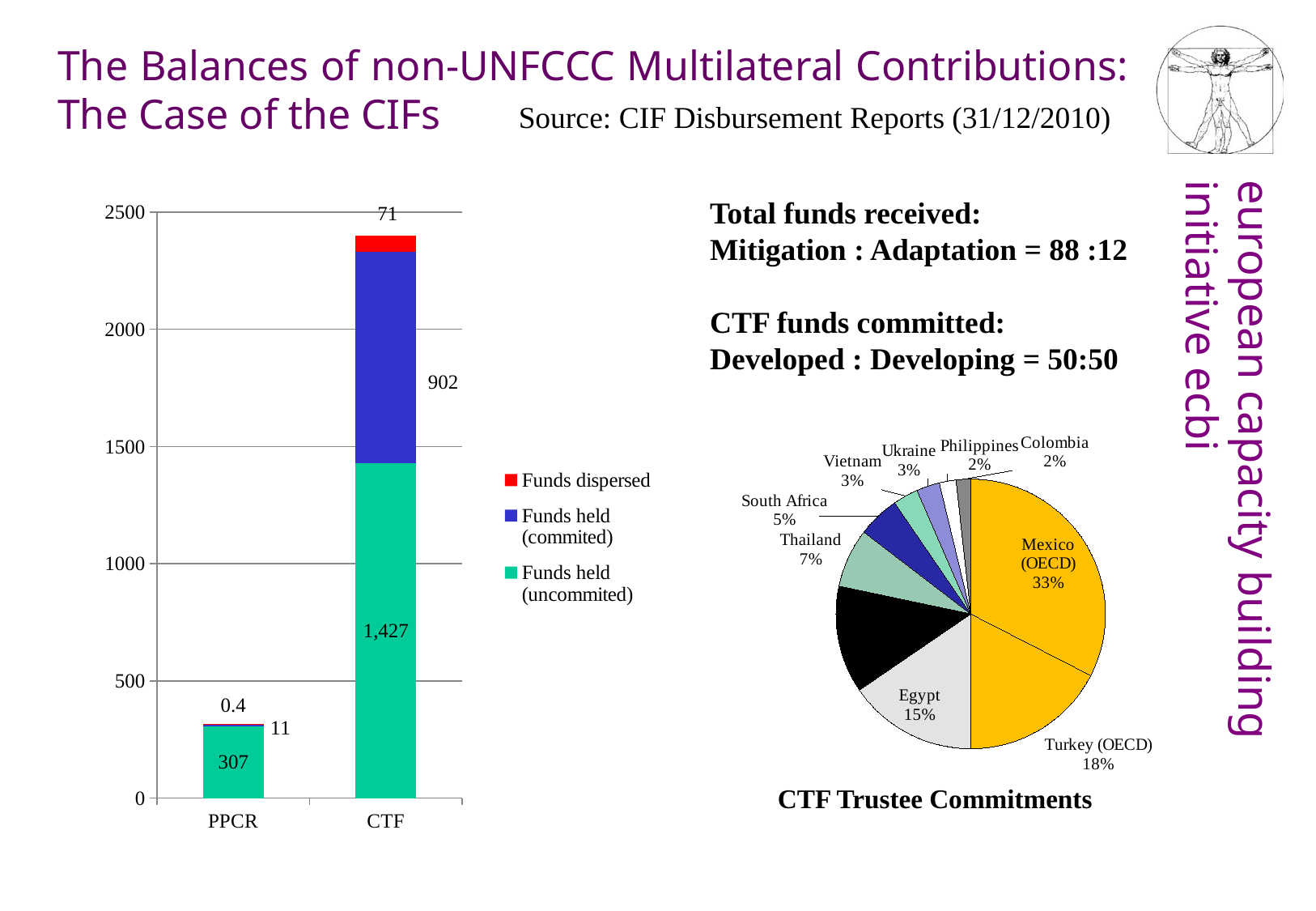
In the CTF Trustee Commitments pie chart, what share does Mexico (OECD) have? 33% In the bar chart on the left, what is the difference between Funds held (uncommited) for CTF and for PPCR? 1,120 In the CTF Trustee Commitments pie chart, which has the larger share, Egypt or Thailand? Egypt In the CTF Trustee Commitments pie chart, what share does Turkey (OECD) have? 18% How many categories are shown on the x axis of the bar chart on the left? 2 In the bar chart on the left, what is the value of Funds held (uncommited) for CTF? 1,427 In the bar chart on the left, what is the total of the stacked bar for CTF? 2,400 In the bar chart on the left, what is the value of Funds held (commited) for PPCR? 11 How many series does the legend of the bar chart on the left list? 3 What kind of chart is the chart on the left of the slide? bar chart In the bar chart on the left, what is the value of Funds dispersed for CTF? 71 In the CTF Trustee Commitments pie chart, which labelled country has the largest share? Mexico (OECD)